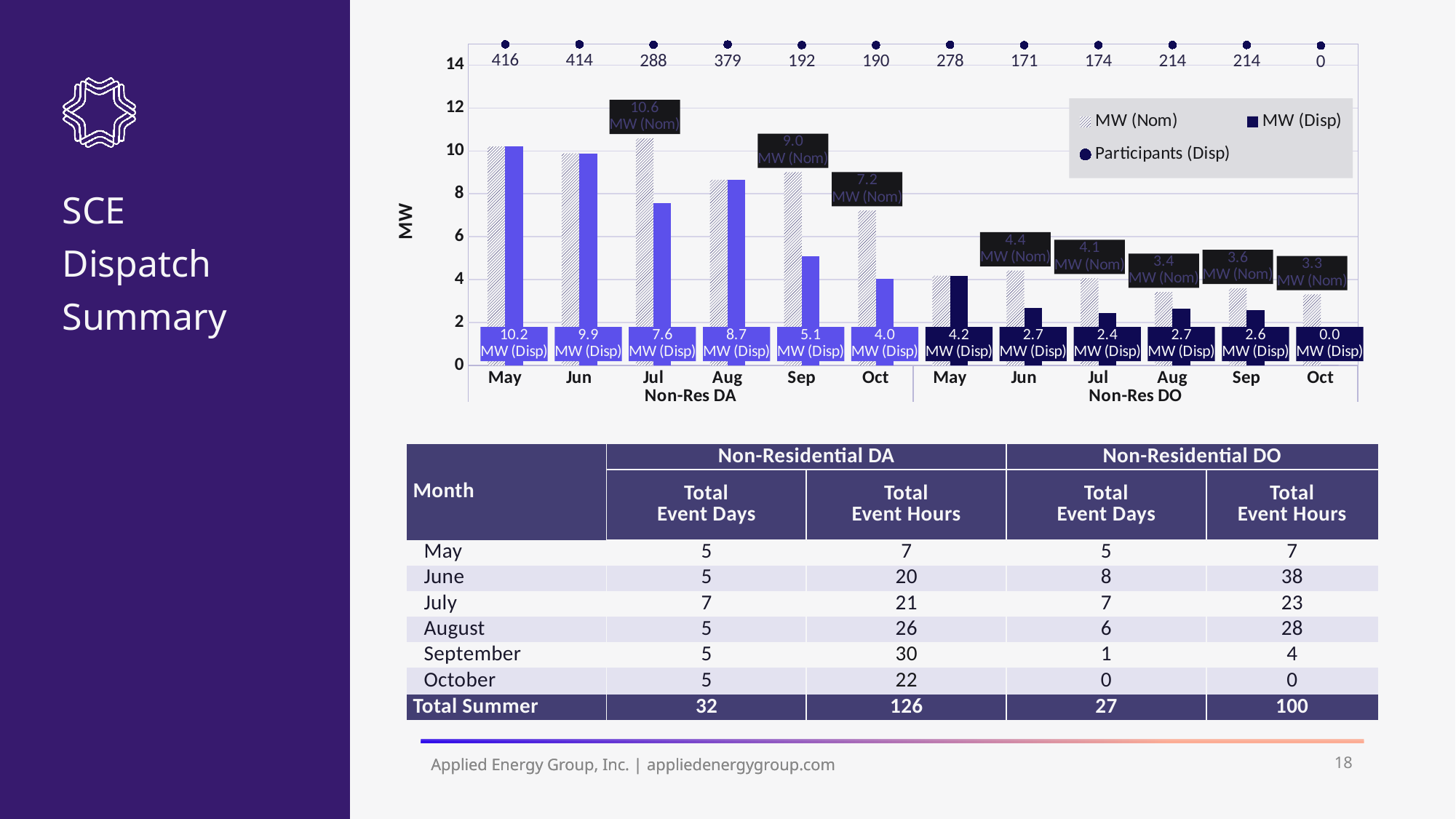
What is the difference between the MW (Nom) and MW (Disp) values for Jul in the Non-Res DA group? 3.0 What kind of chart is shown on the slide? Bar chart How many series does the chart legend list? 3 Do the MW (Disp) values in the Non-Res DA group generally rise or fall from May to Oct? Fall Which month in the Non-Res DA group has the highest MW (Disp) value? May What is the MW (Disp) value for Oct in the Non-Res DO group? 0.0 What is the MW (Disp) value for Jul in the Non-Res DA group? 7.6 What is the MW (Nom) value for Sep in the Non-Res DA group? 9.0 Which month in the Non-Res DO group has the lowest Participants (Disp) value? Oct Which is larger, the MW (Disp) value for Aug in Non-Res DA or the MW (Disp) value for Aug in Non-Res DO? Aug in Non-Res DA Is the MW (Nom) value for May in the Non-Res DA group greater or less than 8? greater How many Participants (Disp) are shown for May in the Non-Res DA group? 416